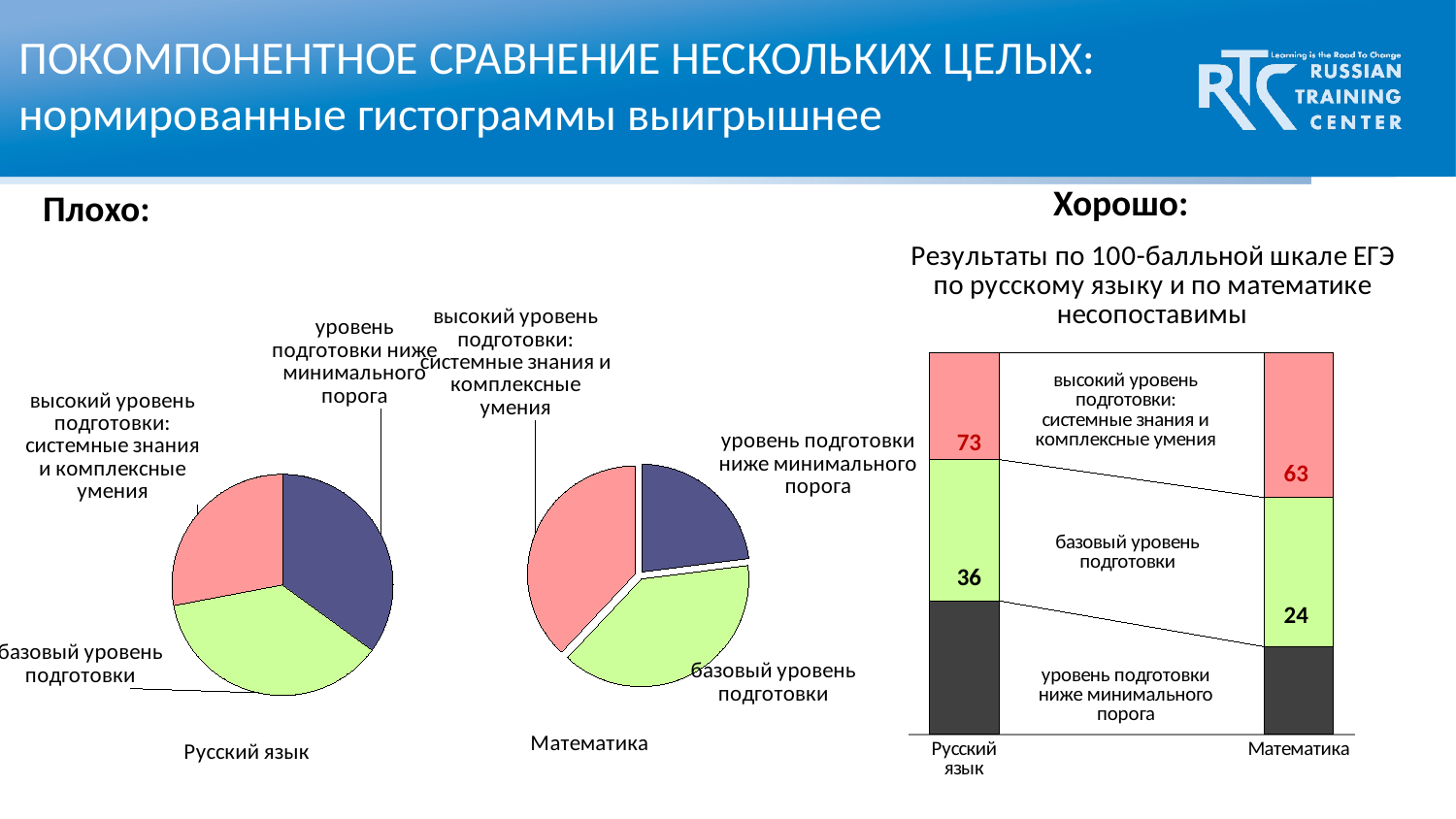
In the stacked bar chart on the right, what number is printed in the pink (высокий уровень подготовки) segment of the 'Русский язык' bar? 73 In the stacked bar chart on the right, what is the difference between the numbers printed in the green segments of 'Русский язык' (36) and 'Математика' (24)? 12 In the stacked bar chart on the right, what number is printed in the pink segment of the 'Математика' bar? 63 In the 'Математика' pie chart, which slice is the smallest? уровень подготовки ниже минимального порога In the stacked bar chart on the right, what number is printed in the green (базовый уровень подготовки) segment of the 'Русский язык' bar? 36 What kind of chart is the chart on the right side of the slide (under 'Хорошо:')? bar chart What is the title of the stacked bar chart on the right side of the slide? Результаты по 100-балльной шкале ЕГЭ по русскому языку и по математике несопоставимы In the stacked bar chart on the right, what number is printed in the green segment of the 'Математика' bar? 24 How many bars are in the stacked bar chart on the right side of the slide? 2 In the stacked bar chart on the right, which bar has the larger number printed in its pink segment, 'Русский язык' or 'Математика'? Русский язык What kind of chart is the 'Русский язык' chart on the left side of the slide? pie chart How many slices does the 'Математика' pie chart have? 3